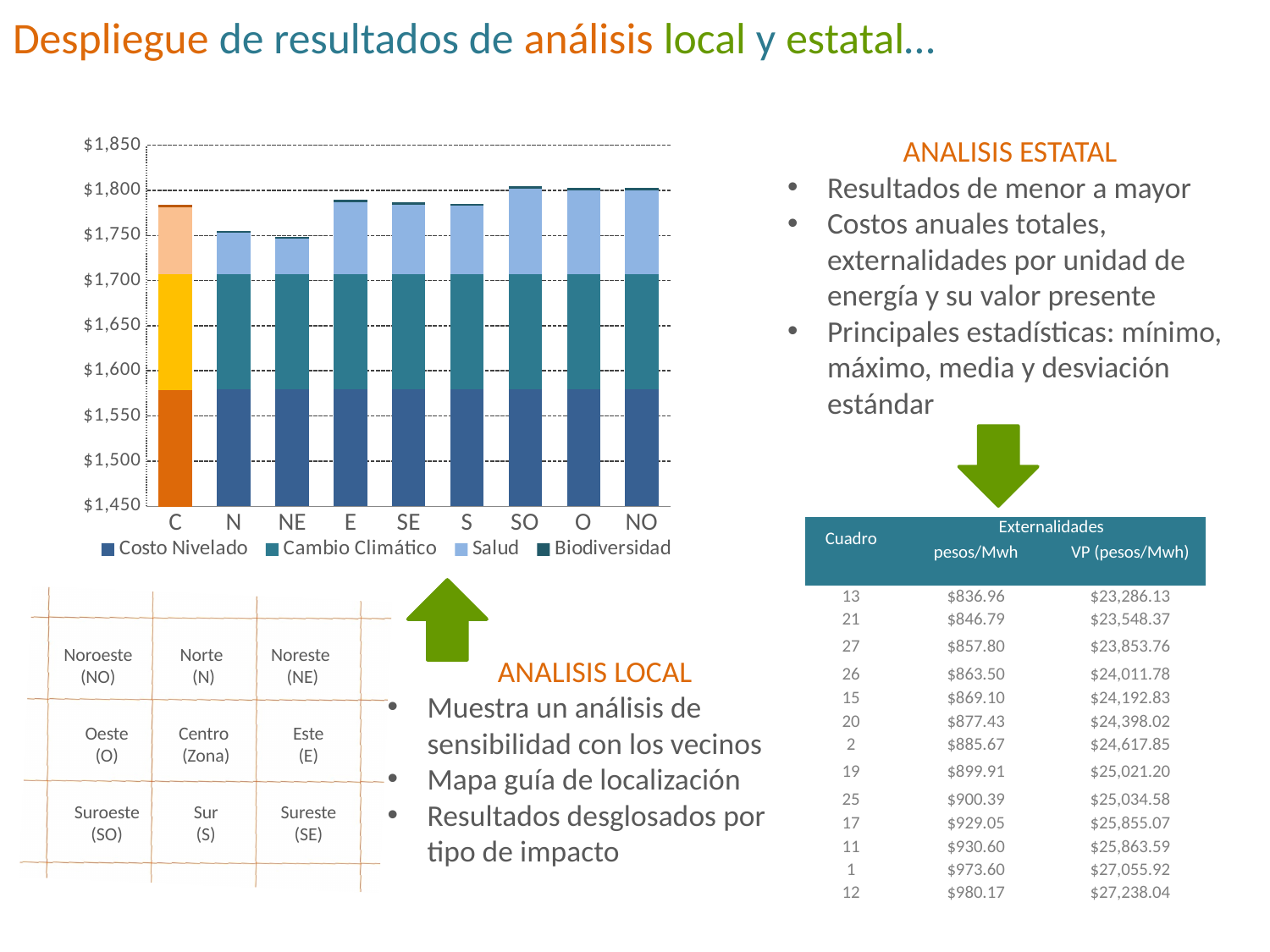
Which stacked bar is taller, E or N? E Is the total value of the stacked bar for SO greater or less than $1,750? greater Is the total value of the stacked bar for N greater or less than $1,800? less How many categories are shown on the x axis of the chart? 9 How many series does the chart legend list? 4 Is the total value of the stacked bar for C greater or less than $1,750? greater Which category on the x axis is drawn in orange and yellow colours instead of blue? C Which stacked bar is taller, SO or NE? SO Which stacked bar is taller, C or NE? C Which series are listed in the chart legend? Costo Nivelado, Cambio Climático, Salud, Biodiversidad What kind of chart is shown on the slide? Stacked bar chart